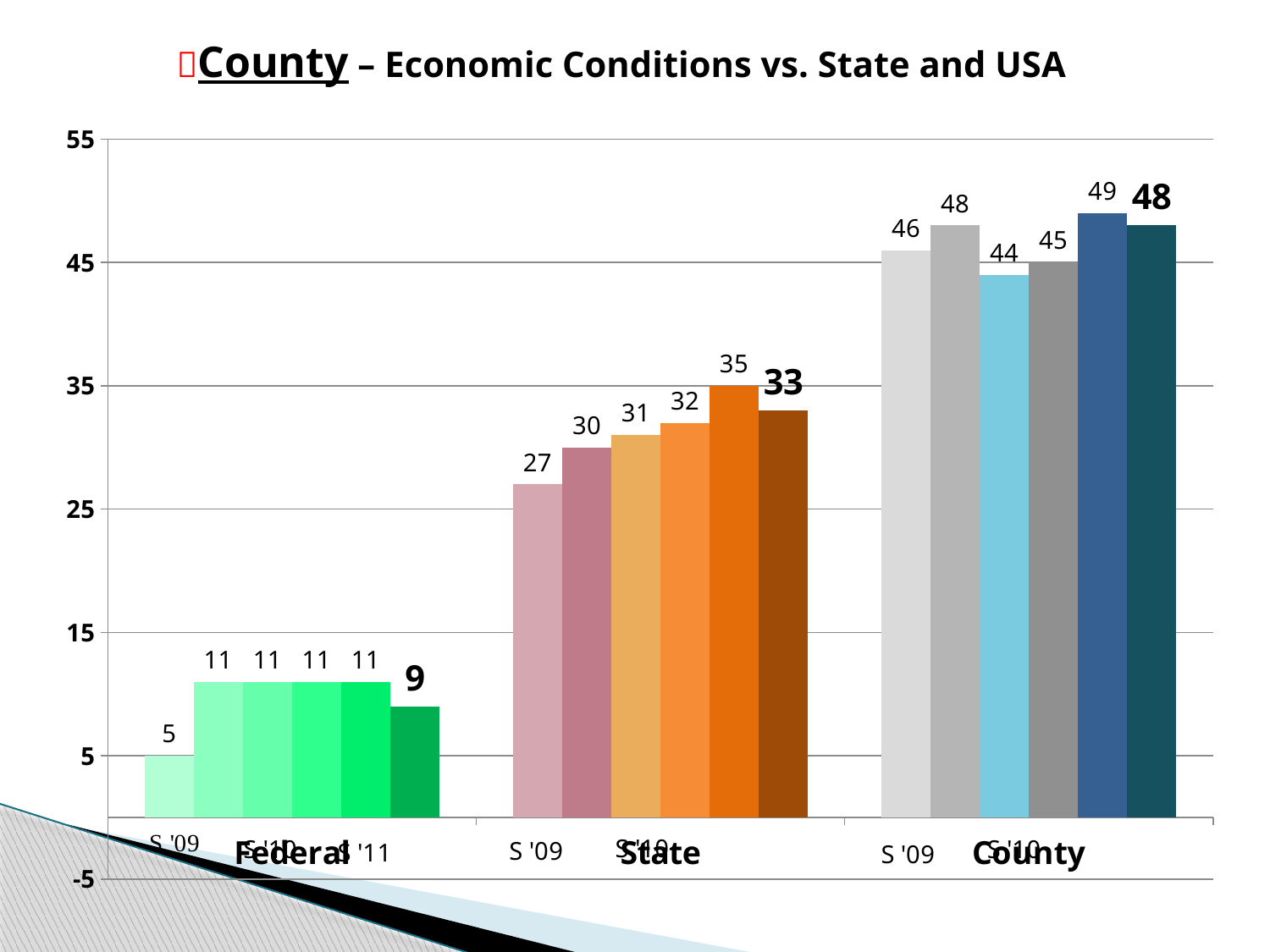
What is the value of the first (S '09) bar in the Federal group? 5 What is the value of the last (bold-labelled) bar in the State group? 33 How many groups of bars are shown on the x axis? 3 Which is larger: the last bar in the Federal group or the first bar in the Federal group? the last bar (9) What is the title of the chart? County – Economic Conditions vs. State and USA What is the value of the first (S '09) bar in the State group? 27 Which bar in the County group has the highest value? the fifth bar (49) Which bar in the State group has the lowest value? the first bar, S '09 (27) What is the difference between the highest State bar (35) and the first State bar (27)? 8 How many bars are in each group (Federal, State, County)? 6 What type of chart is shown on the slide? bar chart What is the value of the last (bold-labelled) bar in the County group? 48